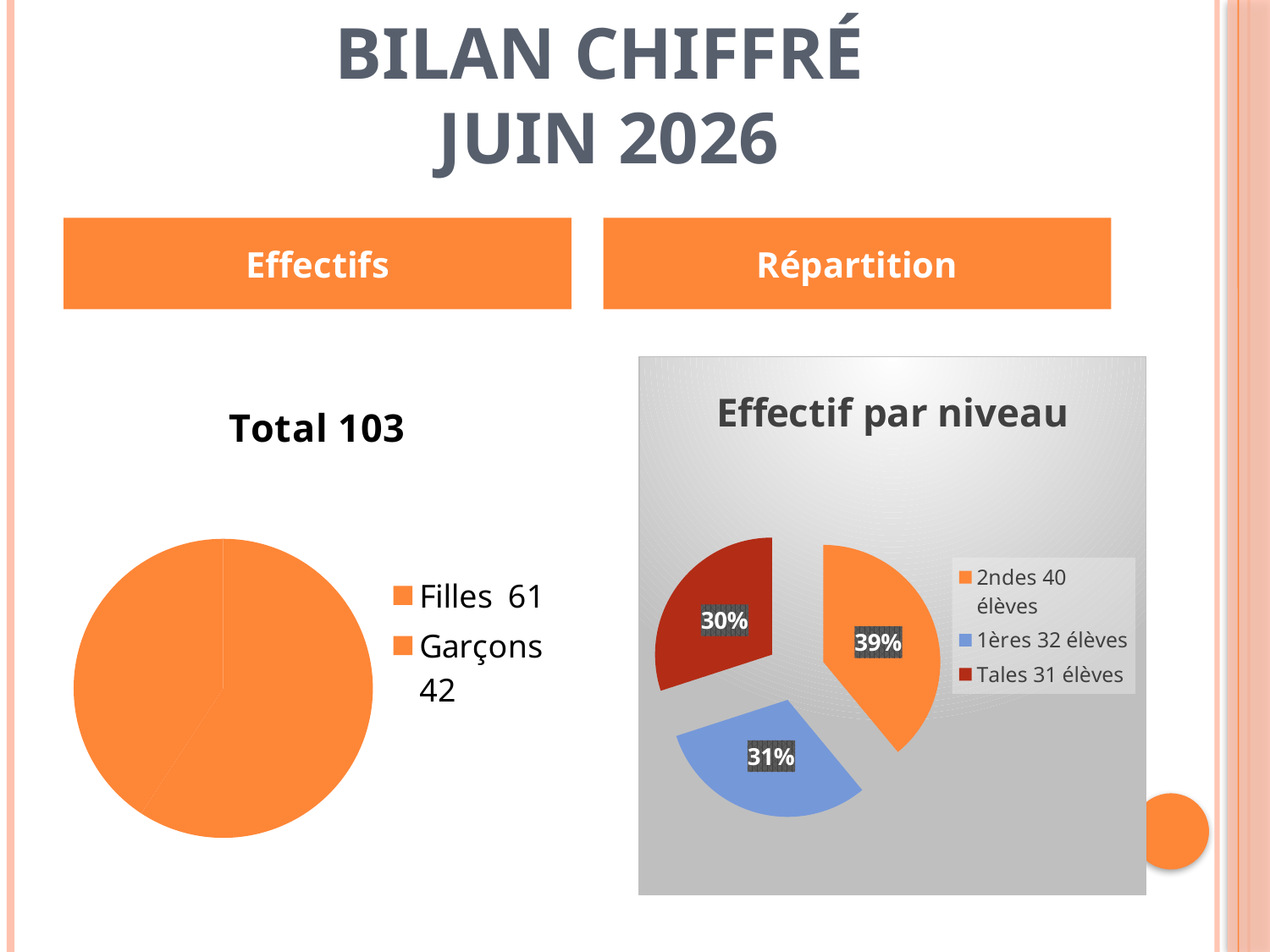
In the 'Total 103' pie chart on the left, which group is larger, Filles or Garçons? Filles In the 'Effectif par niveau' chart, how many categories does the legend list? 3 What kind of chart is the 'Effectif par niveau' chart on the right? pie chart In the 'Effectif par niveau' chart, which level has the largest slice? 2ndes In the 'Total 103' pie chart on the left, how many Filles are listed in the legend? 61 In the 'Effectif par niveau' chart, how many élèves does the legend give for 1ères? 32 élèves In the 'Effectif par niveau' chart, what percentage share is shown for the 1ères slice? 31% In the 'Effectif par niveau' chart, what percentage share is shown for the Tales slice? 30% In the 'Effectif par niveau' chart, what colour is the Tales slice? dark red In the 'Effectif par niveau' chart, what is the difference in élèves between 2ndes and Tales? 9 In the 'Total 103' pie chart on the left, what is the difference between Filles and Garçons? 19 In the 'Effectif par niveau' chart, what percentage share is shown for the 2ndes slice? 39%